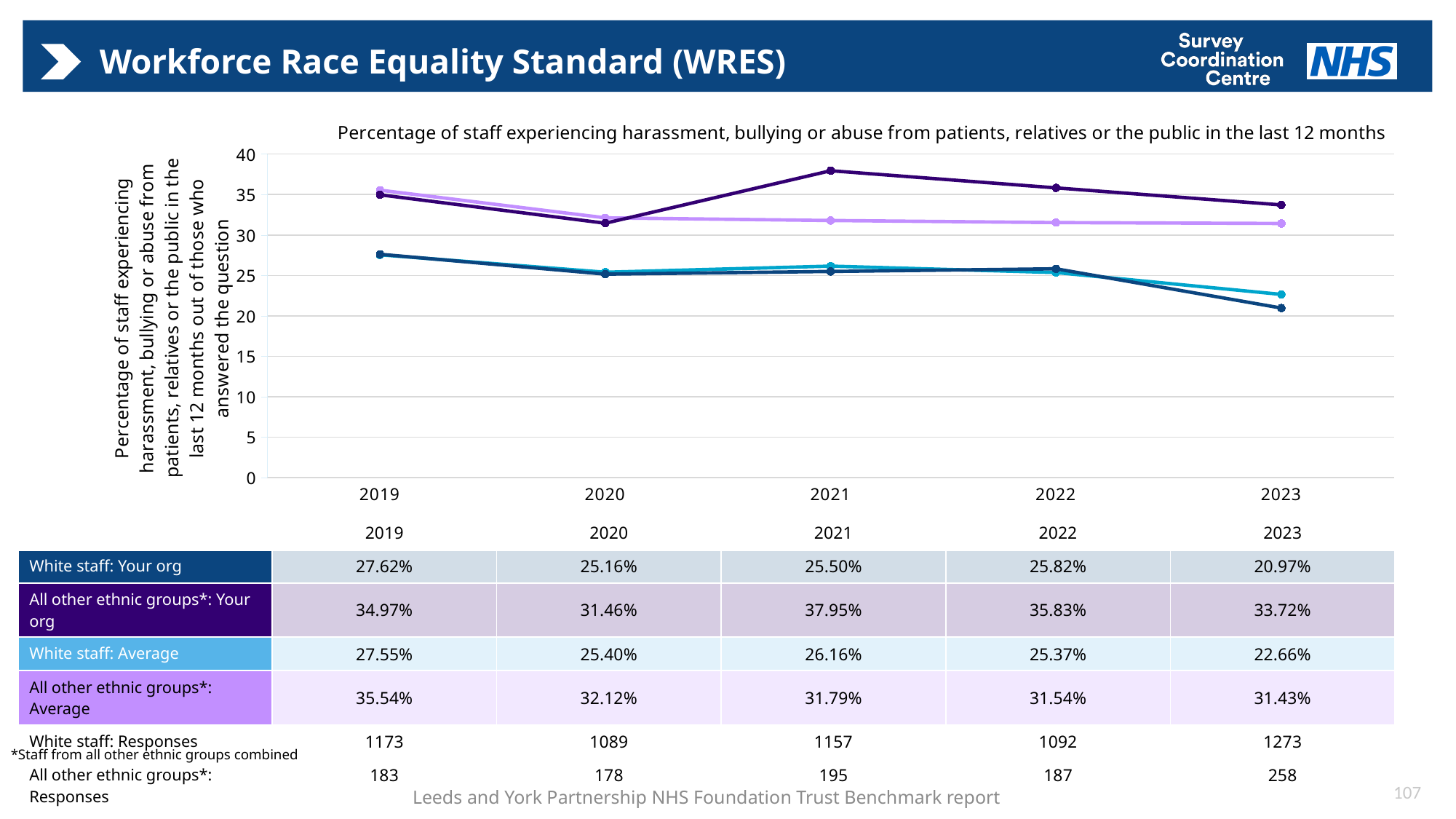
What was the percentage for 'All other ethnic groups*: Your org' in 2021? 37.95% What is the difference between 'All other ethnic groups*: Your org' and 'White staff: Your org' in 2023? 12.75% How many years are shown on the x axis of the chart? 5 What was the percentage for 'All other ethnic groups*: Average' in 2019? 35.54% In which year was the value for 'All other ethnic groups*: Your org' highest? 2021 What was the percentage for 'White staff: Average' in 2020? 25.40% In which year was the value for 'White staff: Your org' lowest? 2023 In 2022, which was higher: 'All other ethnic groups*: Your org' or 'All other ethnic groups*: Average'? All other ethnic groups*: Your org What was the percentage for 'White staff: Your org' in 2023? 20.97% What type of chart is shown on the slide? line chart How many data series are plotted on the chart? 4 Did the value for 'All other ethnic groups*: Average' rise or fall from 2019 to 2023? fall